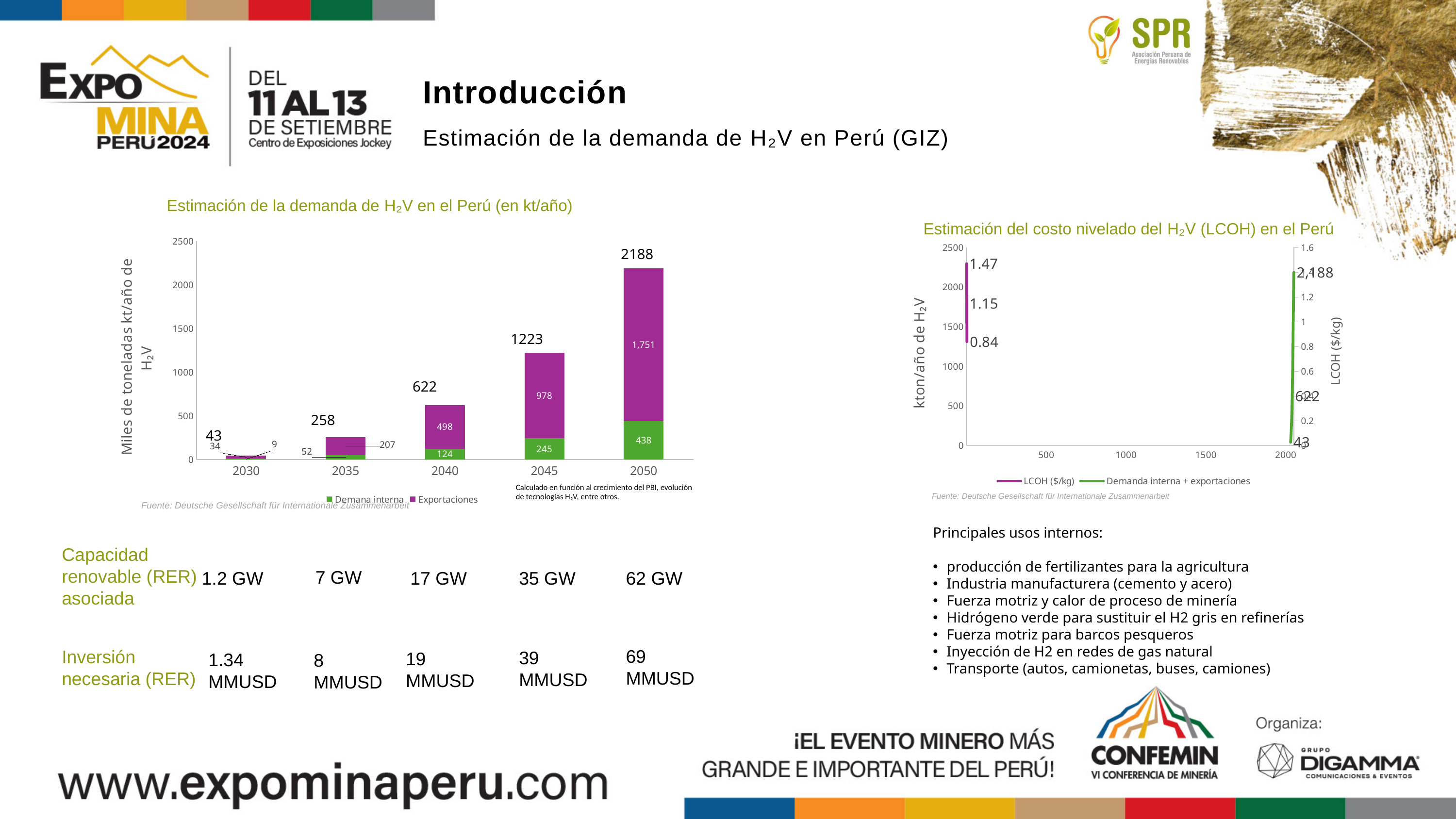
In the chart 'Estimación de la demanda de H₂V en el Perú (en kt/año)', how many years are shown on the x axis? 5 In the chart 'Estimación de la demanda de H₂V en el Perú (en kt/año)', how many series does the legend list? 2 In the chart 'Estimación de la demanda de H₂V en el Perú (en kt/año)', what is the Demana interna value for 2040? 124 In the chart 'Estimación de la demanda de H₂V en el Perú (en kt/año)', what is the Exportaciones value for 2045? 978 In the chart 'Estimación de la demanda de H₂V en el Perú (en kt/año)', what is the total demand shown for 2050? 2188 In the chart 'Estimación de la demanda de H₂V en el Perú (en kt/año)', do the total values rise or fall from 2030 to 2050? Rise What kind of chart is 'Estimación de la demanda de H₂V en el Perú (en kt/año)'? Stacked bar chart In the chart 'Estimación de la demanda de H₂V en el Perú (en kt/año)', which year has the highest total demand? 2050 In the chart 'Estimación de la demanda de H₂V en el Perú (en kt/año)', which year has the lowest total demand? 2030 In the chart 'Estimación de la demanda de H₂V en el Perú (en kt/año)', what is the difference between the total for 2050 and the total for 2045? 965 In the chart 'Estimación de la demanda de H₂V en el Perú (en kt/año)', which is larger for 2035: Demana interna or Exportaciones? Exportaciones In the chart 'Estimación del costo nivelado del H₂V (LCOH) en el Perú', how many series does the legend list? 2